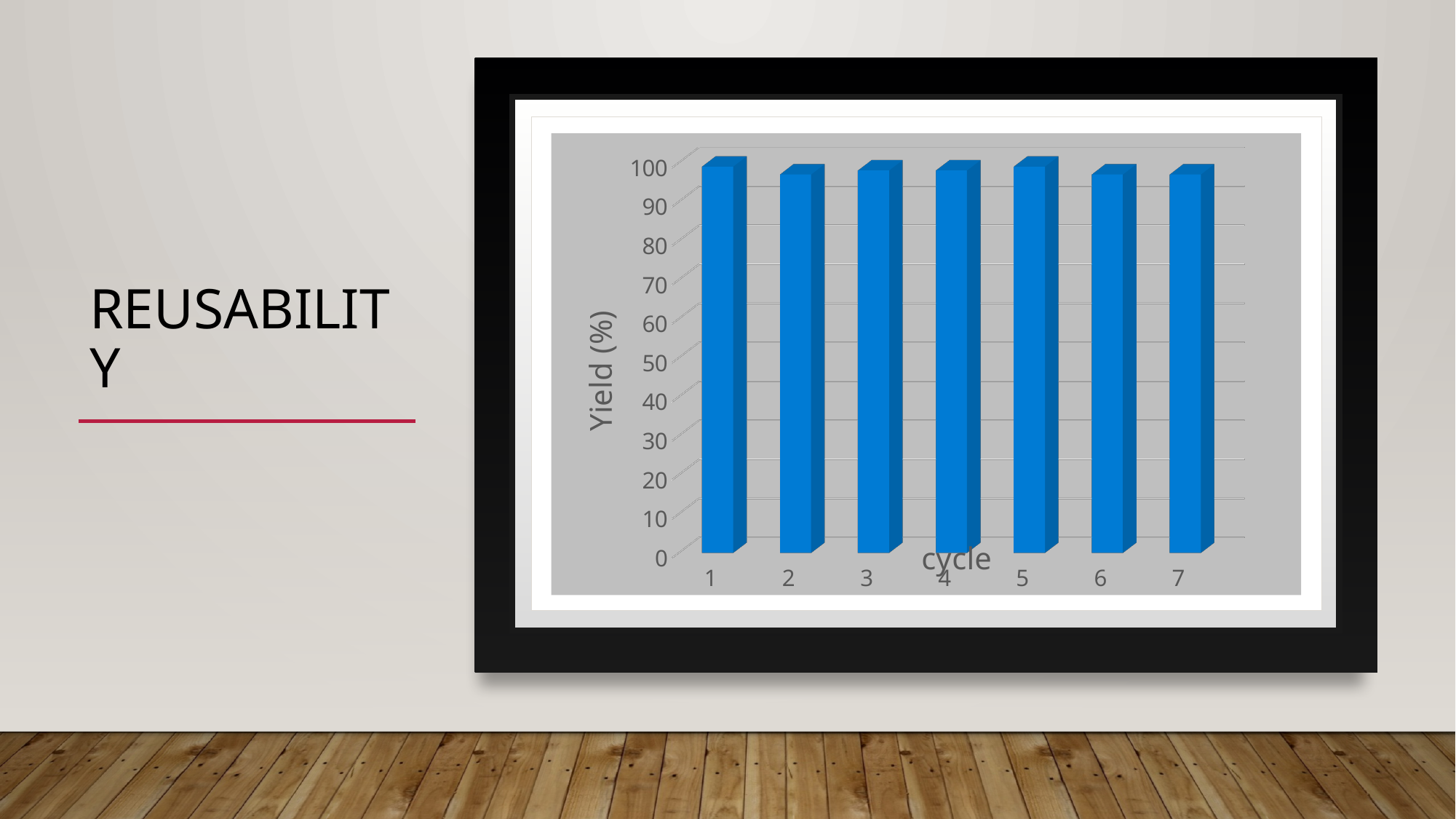
Do the yield values rise, fall, or stay roughly constant across the cycles? stay roughly constant What is the label of the horizontal axis of the chart? cycle Is the yield for cycle 7 greater or less than 90? greater Is the yield for cycle 2 greater or less than 50? greater Is the yield for cycle 6 greater or less than 100? less What kind of chart is shown on the slide? bar chart What is the label of the vertical axis of the chart? Yield (%) How many cycles are plotted on the x axis of the chart? 7